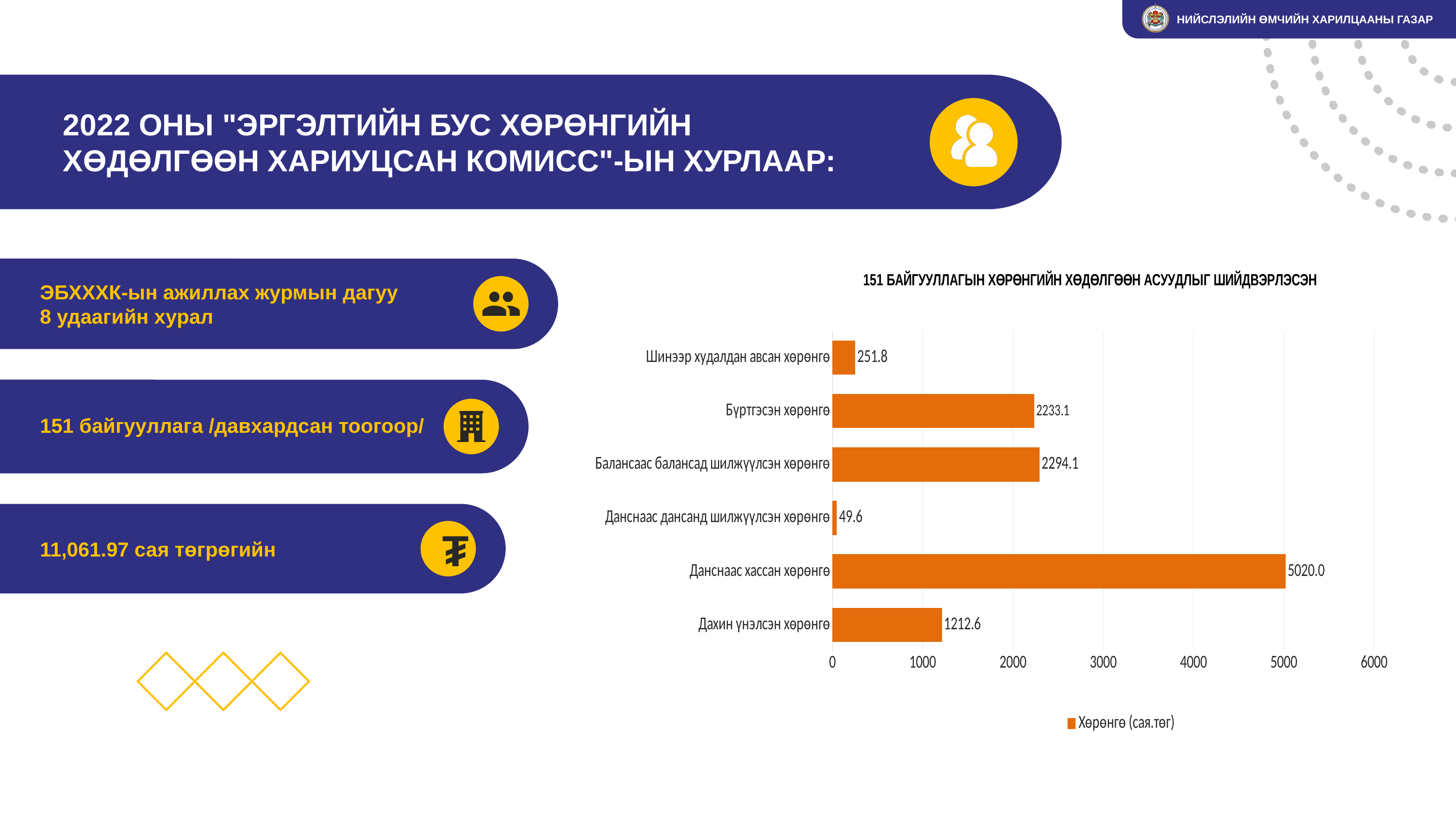
Which is larger: Бүртгэсэн хөрөнгө or Дахин үнэлсэн хөрөнгө? Бүртгэсэн хөрөнгө Is the value for Балансаас балансад шилжүүлсэн хөрөнгө greater or less than 2000? greater What is the difference between Шинээр худалдан авсан хөрөнгө and Данснаас дансанд шилжүүлсэн хөрөнгө? 202.2 What is the difference between Данснаас хассан хөрөнгө and Дахин үнэлсэн хөрөнгө? 3807.4 What is the legend entry of the chart? Хөрөнгө (сая.төг) What is the value for Шинээр худалдан авсан хөрөнгө? 251.8 How many categories are shown in the chart? 6 Which category has the highest value? Данснаас хассан хөрөнгө What is the value for Дахин үнэлсэн хөрөнгө? 1212.6 What is the value for Данснаас хассан хөрөнгө? 5020.0 What kind of chart is shown on the slide? bar chart Which category has the lowest value? Данснаас дансанд шилжүүлсэн хөрөнгө